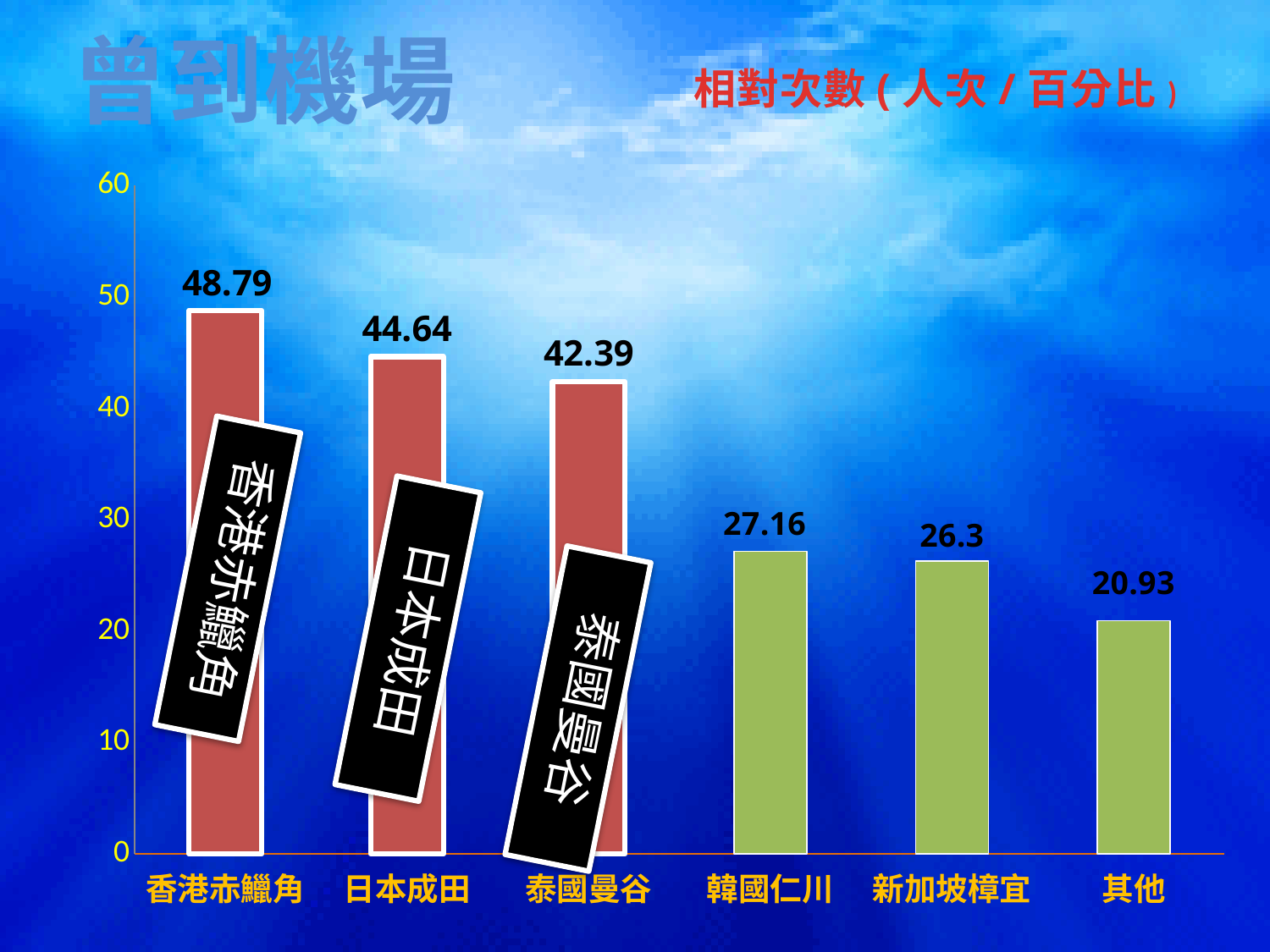
What is the value for 日本成田? 44.64 What is the value for 泰國曼谷? 42.39 Which is larger, the value for 韓國仁川 or the value for 新加坡樟宜? 韓國仁川 How many categories are shown on the x axis? 6 What is the value for 韓國仁川? 27.16 What is the value for 新加坡樟宜? 26.3 Which category has the highest value? 香港赤鱲角 What kind of chart is shown on the slide? bar chart Which category has the lowest value? 其他 What is the difference between the values for 香港赤鱲角 and 日本成田? 4.15 What is the value for 其他? 20.93 What is the value for 香港赤鱲角? 48.79